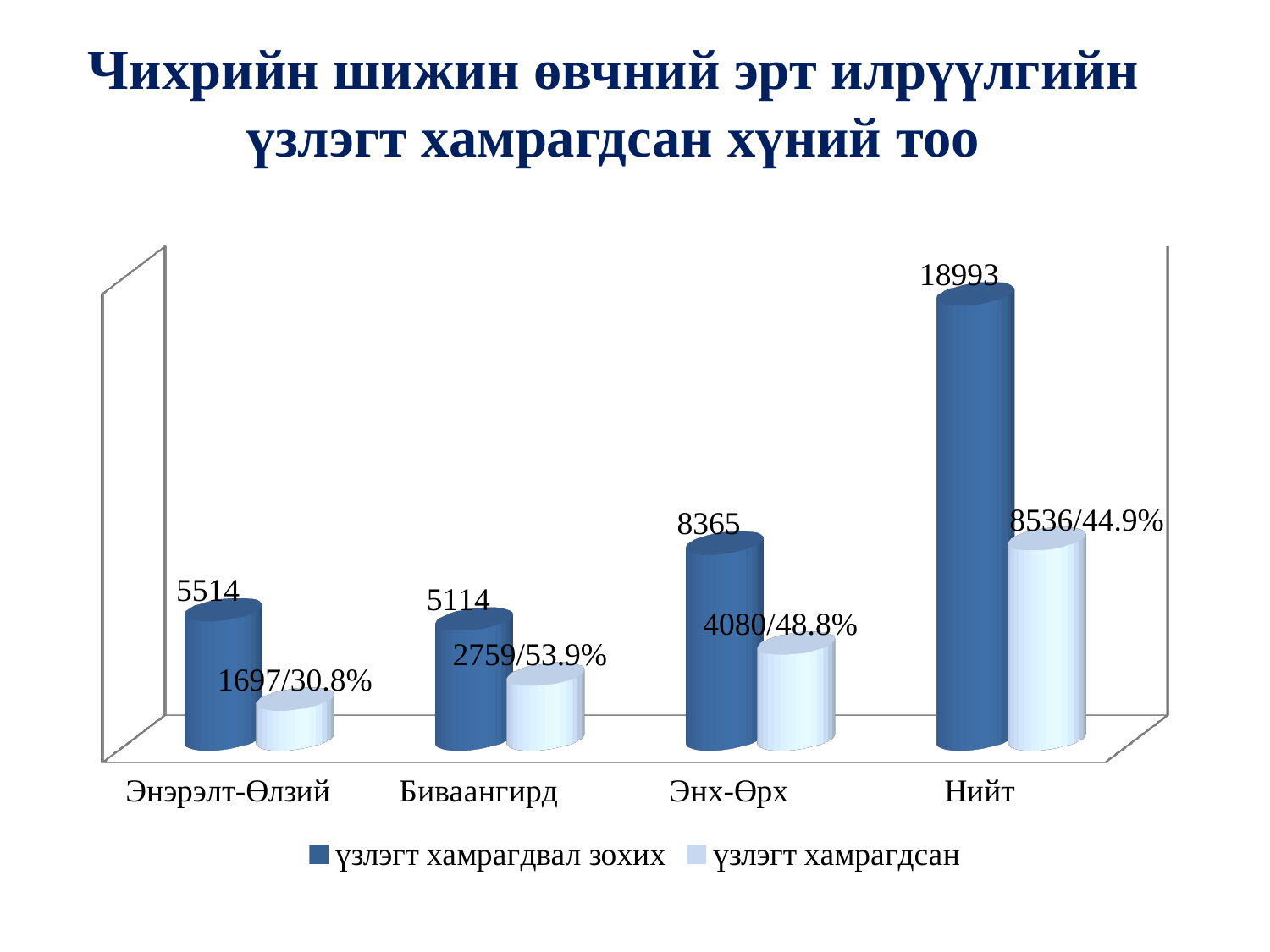
How many series does the legend list? 2 What is the data label on the "үзлэгт хамрагдсан" bar for Энэрэлт-Өлзий? 1697/30.8% Which category has the highest percentage shown in the "үзлэгт хамрагдсан" labels? Биваангирд Which category has the highest value for "үзлэгт хамрагдвал зохих"? Нийт Which category has the lowest value for "үзлэгт хамрагдсан"? Энэрэлт-Өлзий What is the value of "үзлэгт хамрагдвал зохих" for Биваангирд? 5114 What kind of chart is shown on the slide? Bar chart What is the data label on the "үзлэгт хамрагдсан" bar for Энх-Өрх? 4080/48.8% Which is larger: "үзлэгт хамрагдвал зохих" for Энэрэлт-Өлзий or for Биваангирд? Энэрэлт-Өлзий What is the difference between "үзлэгт хамрагдвал зохих" and "үзлэгт хамрагдсан" for Энх-Өрх? 4285 What is the value of "үзлэгт хамрагдвал зохих" for Нийт? 18993 How many categories are shown on the x axis? 4